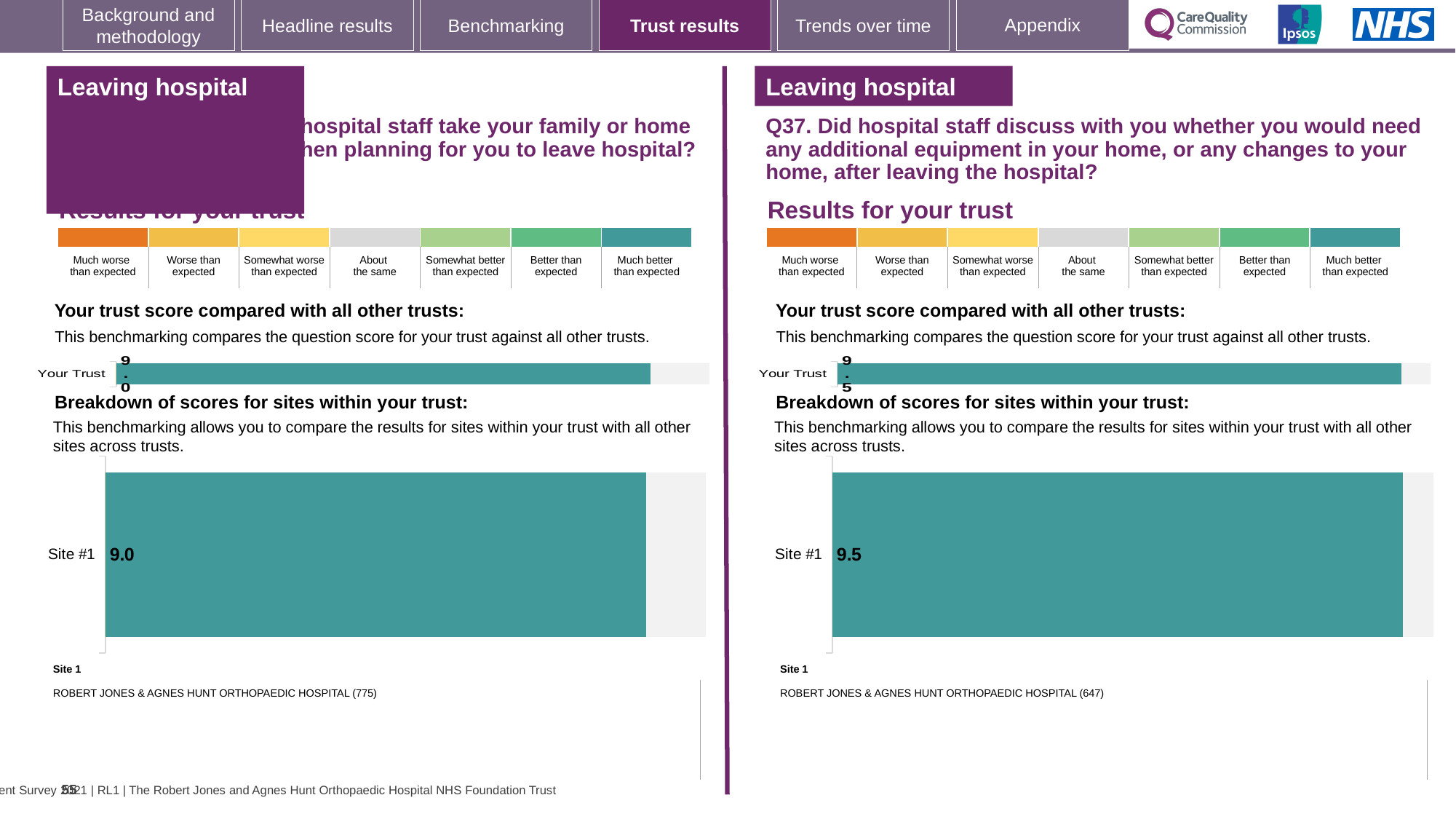
According to the colour key above the right-hand (Q37) charts, which benchmark category does the teal colour of the bars represent? Much better than expected What is the difference between the Site #1 score on the right-hand (Q37) breakdown chart and the Site #1 score on the left-hand breakdown chart? 0.5 On the right-hand (Q37) breakdown chart, which hospital is listed as Site 1? ROBERT JONES & AGNES HUNT ORTHOPAEDIC HOSPITAL Which is larger: the Your Trust score on the left-hand trust chart or the Your Trust score on the right-hand (Q37) trust chart? The right-hand (Q37) chart On the left-hand 'Your trust score compared with all other trusts' chart, what is the score shown for Your Trust? 9.0 Which is larger: the Site #1 score on the left-hand breakdown chart or the Site #1 score on the right-hand (Q37) breakdown chart? The right-hand (Q37) chart On the left-hand 'Breakdown of scores for sites within your trust' chart, what is the score for Site #1? 9.0 On the right-hand (Q37) 'Breakdown of scores for sites within your trust' chart, what is the score for Site #1? 9.5 What type of chart is used to show the Site #1 score on the right-hand (Q37) breakdown chart? Bar chart How many sites are shown in the right-hand (Q37) 'Breakdown of scores for sites within your trust' chart? 1 On the right-hand (Q37) 'Your trust score compared with all other trusts' chart, what is the score shown for Your Trust? 9.5